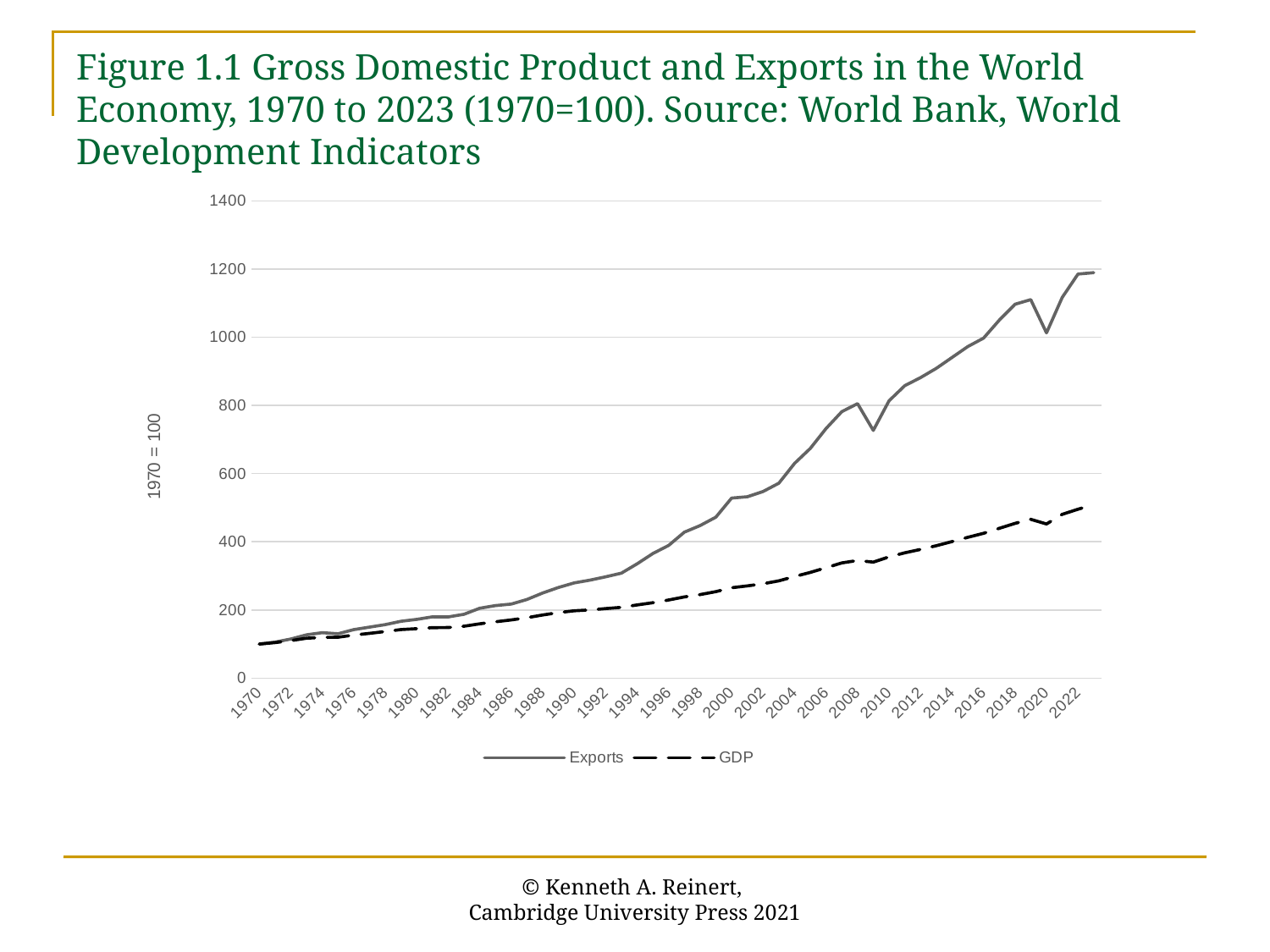
Does the GDP series generally rise or fall across the years shown? Rise Which series reaches the highest value on the chart? Exports Which two series are listed in the chart legend? Exports and GDP Do the Exports values generally rise or fall from 1970 to 2022? Rise What is the label on the vertical axis of the chart? 1970 = 100 How many series does the legend list? 2 Is the value for Exports in 2022 greater or less than 1000? greater Is the value for GDP in 2022 greater or less than 600? less What kind of chart is shown on the slide? Line chart Is the value for Exports in 2000 greater or less than 400? greater In 2022, which series has the larger value, Exports or GDP? Exports